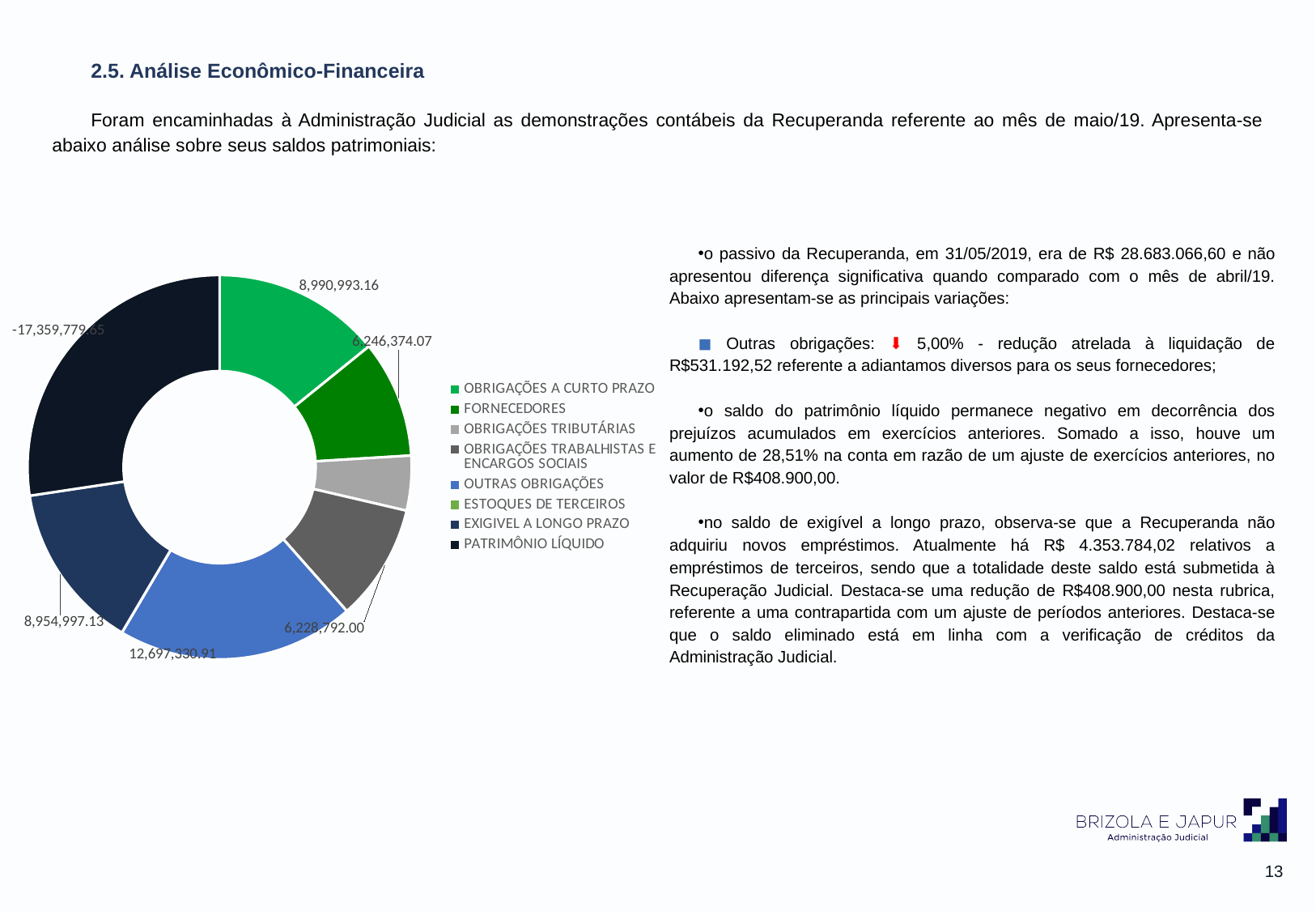
How many categories does the chart legend list? 8 What is the value shown for OBRIGAÇÕES A CURTO PRAZO? 8,990,993.16 What is the value shown for FORNECEDORES? 6,246,374.07 What is the difference between the values for OBRIGAÇÕES A CURTO PRAZO and FORNECEDORES? 2,744,619.09 Which slice is larger, OUTRAS OBRIGAÇÕES or OBRIGAÇÕES A CURTO PRAZO? OUTRAS OBRIGAÇÕES Which category occupies the largest slice of the chart? PATRIMÔNIO LÍQUIDO What is the difference between the values for FORNECEDORES and OBRIGAÇÕES TRABALHISTAS E ENCARGOS SOCIAIS? 17,582.07 What is the value shown for OBRIGAÇÕES TRABALHISTAS E ENCARGOS SOCIAIS? 6,228,792.00 Which legend entry is shown in the lightest grey colour? OBRIGAÇÕES TRIBUTÁRIAS What is the value shown for EXIGIVEL A LONGO PRAZO? 8,954,997.13 What type of chart is shown on the slide? Doughnut (pie) chart Which slice is larger, OBRIGAÇÕES TRIBUTÁRIAS or OBRIGAÇÕES TRABALHISTAS E ENCARGOS SOCIAIS? OBRIGAÇÕES TRABALHISTAS E ENCARGOS SOCIAIS